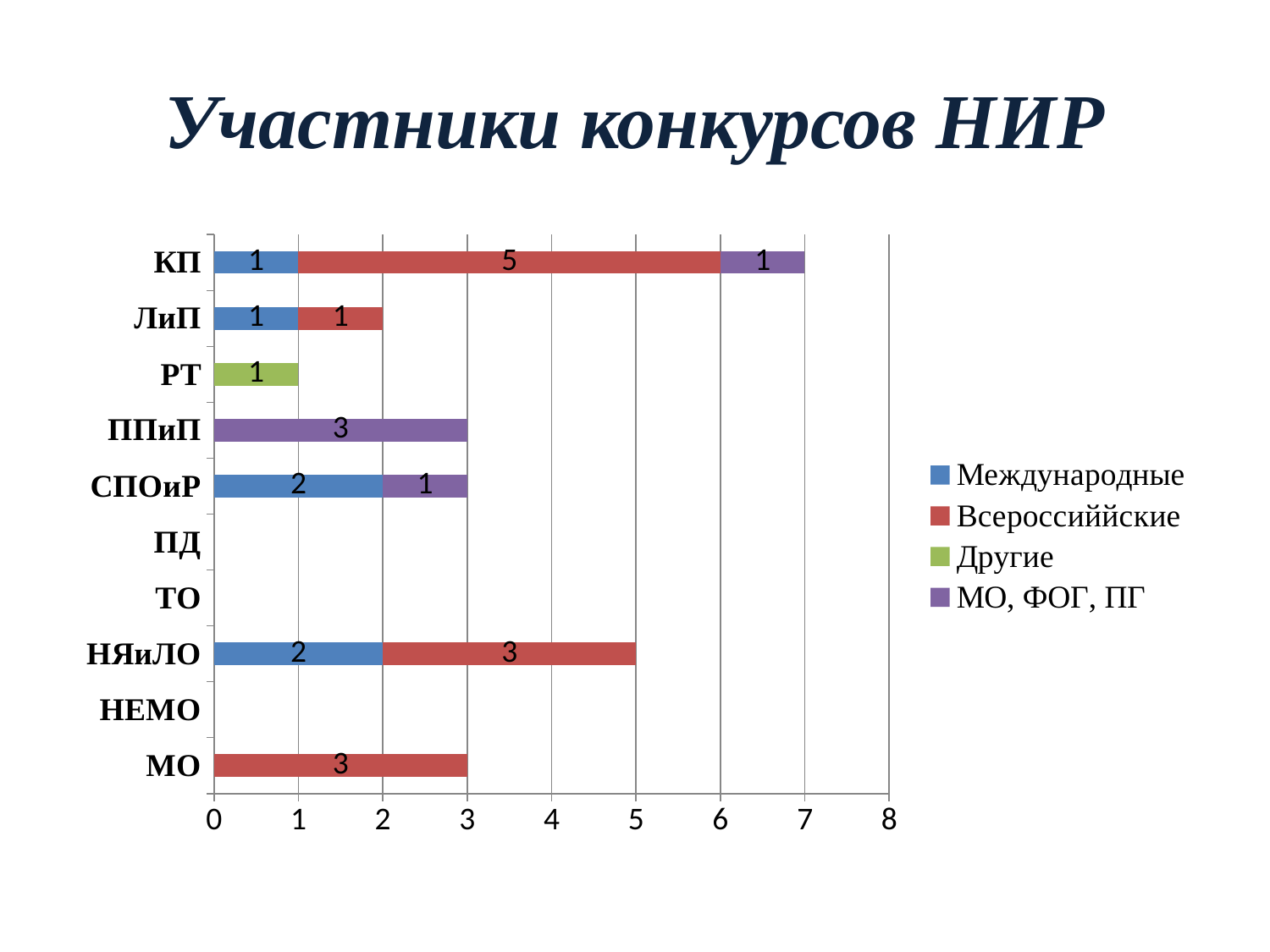
What is the title of the chart? Участники конкурсов НИР Which category has the longest stacked bar overall? КП What is the total of the stacked bar for КП? 7 What is the total of the stacked bar for НЯиЛО? 5 What is the value of the МО, ФОГ, ПГ series for ППиП? 3 What is the value of the Международные series for НЯиЛО? 2 How many categories are shown on the vertical axis? 10 Which is larger: the total bar for СПОиР or the total bar for НЯиЛО? НЯиЛО What is the value of the Всероссиийские series for КП? 5 How many series does the legend list? 4 What is the difference between the Всероссиийские value for КП and the Всероссиийские value for МО? 2 What kind of chart is shown on the slide? stacked bar chart